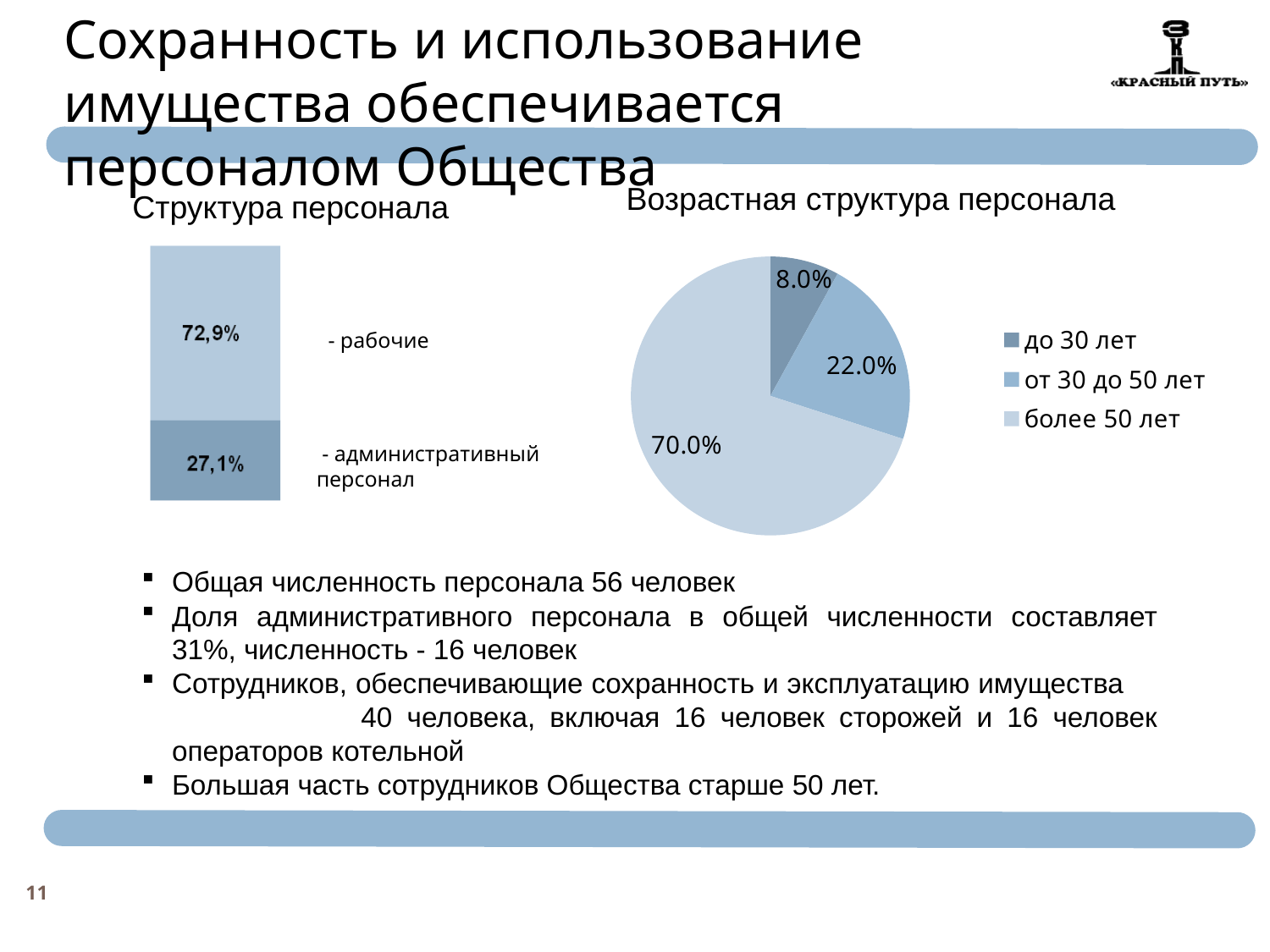
In the 'Возрастная структура персонала' chart, which age group has the largest share? более 50 лет In the 'Возрастная структура персонала' chart, what share of staff is 'от 30 до 50 лет'? 22.0% What kind of chart is 'Возрастная структура персонала'? Pie chart In the 'Возрастная структура персонала' chart, what share of staff is 'до 30 лет'? 8.0% In the 'Структура персонала' chart, what is the value for 'административный персонал'? 27,1% In the 'Возрастная структура персонала' chart, what is the difference between the shares of 'более 50 лет' and 'от 30 до 50 лет'? 48.0% In the 'Структура персонала' chart, which group is larger: 'рабочие' or 'административный персонал'? рабочие How many categories does the legend of the 'Возрастная структура персонала' chart list? 3 In the 'Структура персонала' chart, what is the value for 'рабочие'? 72,9% In the 'Возрастная структура персонала' chart, what share of staff is 'более 50 лет'? 70.0% In the 'Возрастная структура персонала' chart, which age group has the smallest share? до 30 лет What kind of chart is 'Структура персонала'? Stacked bar chart